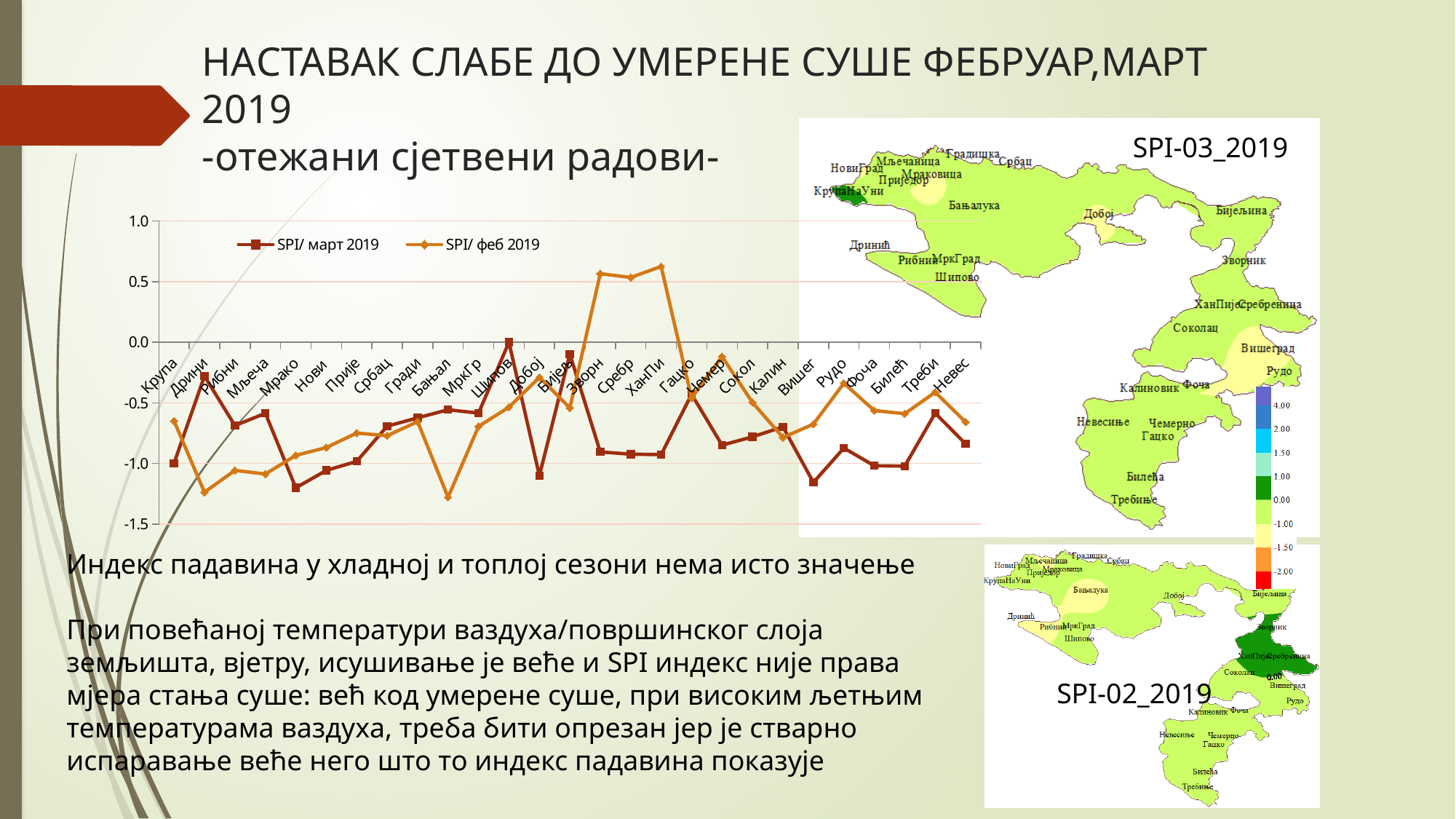
What is the title of the larger map on the right of the slide? SPI-03_2019 In the line chart, is the SPI/ март 2019 value for Мрако greater or less than -1.0? less In the line chart, which category has the highest value for the SPI/ феб 2019 series? ХанПи In the line chart, is the SPI/ феб 2019 value for Зворн greater or less than 0.5? greater How many categories are shown along the x axis of the line chart? 27 In the line chart, is the SPI/ феб 2019 value for Бањал greater or less than -1.0? less In the line chart, which series has the larger value at Зворн, SPI/ март 2019 or SPI/ феб 2019? SPI/ феб 2019 What kind of chart is the chart on the left of the slide? line chart In the line chart, which category has the highest value for the SPI/ март 2019 series? Шипов How many series does the legend of the line chart list? 2 In the line chart, which series has the larger value at Дрини, SPI/ март 2019 or SPI/ феб 2019? SPI/ март 2019 What are the two series named in the legend of the line chart? SPI/ март 2019 and SPI/ феб 2019